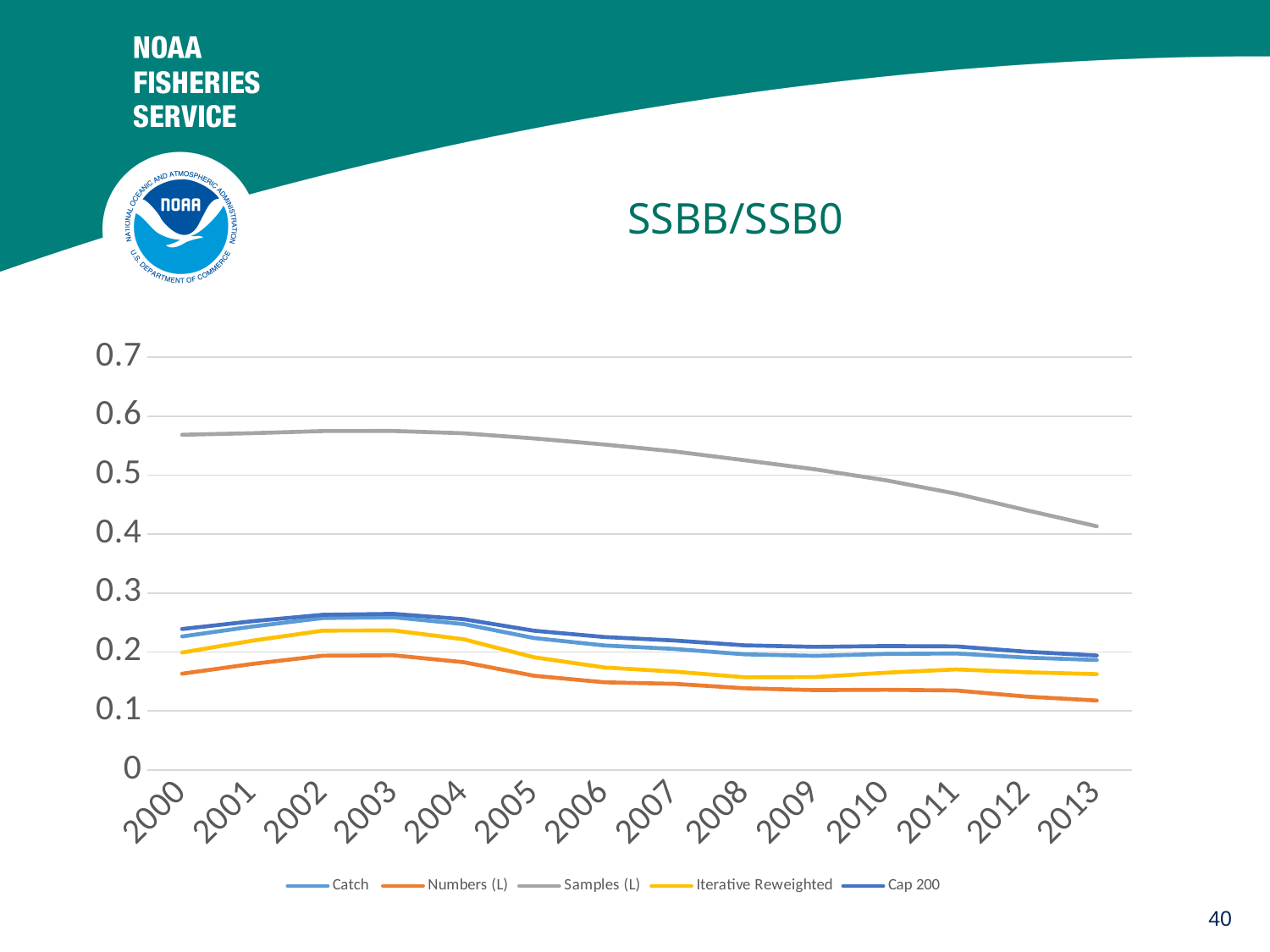
What kind of chart is shown on the slide? line chart Which series has the highest values across all years? Samples (L) Which series has the lowest values across all years? Numbers (L) Is the value for Numbers (L) in 2013 greater or less than 0.2? less Is the value for Samples (L) in 2013 greater or less than 0.5? less Is the value for Samples (L) in 2000 greater or less than 0.5? greater In 2005, which is larger: the value for Samples (L) or the value for Numbers (L)? Samples (L) Does the Samples (L) series rise or fall from 2003 to 2013? fall What is the title of the chart? SSBB/SSB0 How many series does the legend list? 5 How many years are shown along the x axis? 14